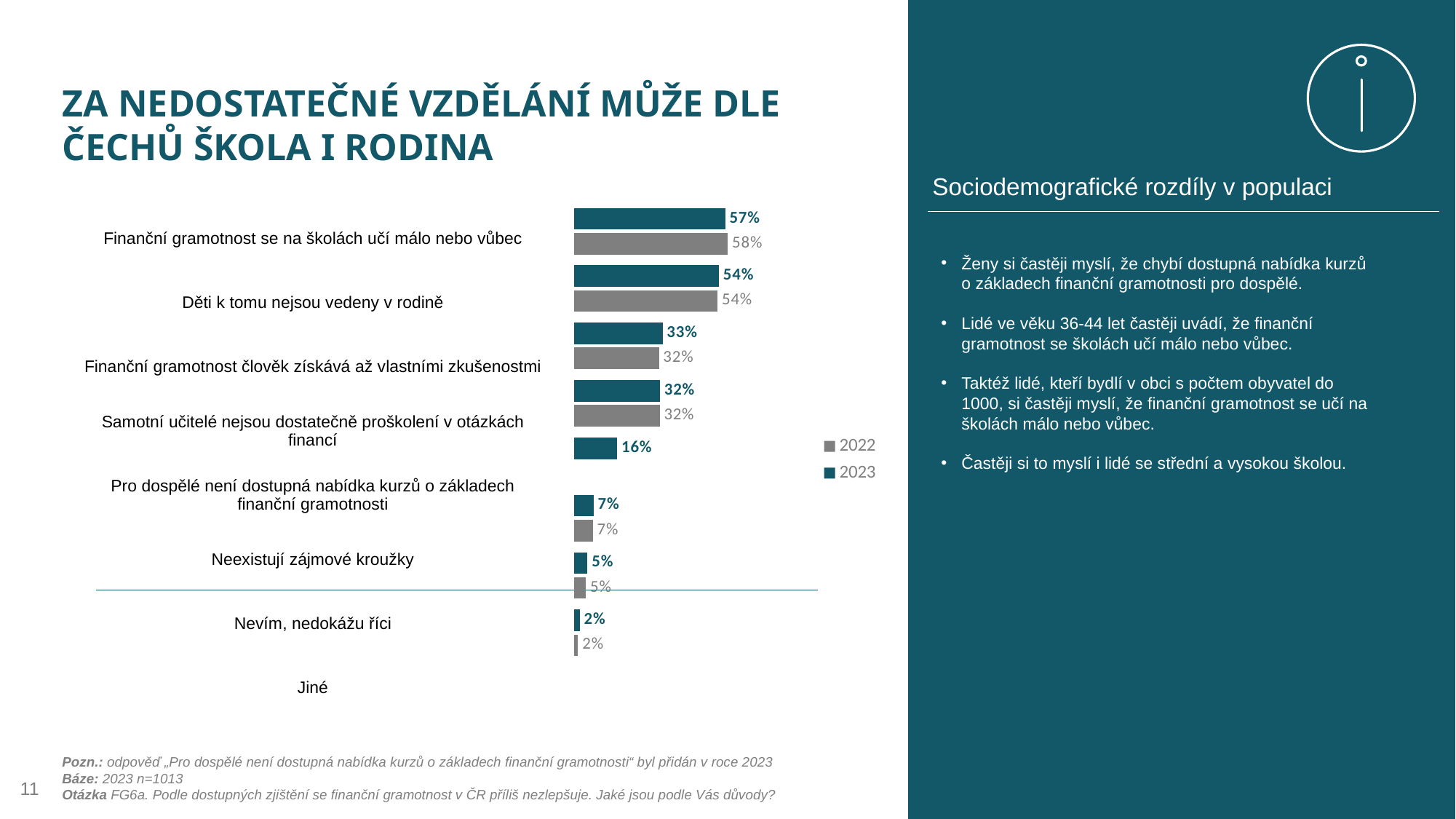
What is the 2022 value for "Finanční gramotnost se na školách učí málo nebo vůbec"? 58% What kind of chart is shown on the slide? bar chart What is the 2023 value for "Děti k tomu nejsou vedeny v rodině"? 54% What is the 2023 value for "Finanční gramotnost se na školách učí málo nebo vůbec"? 57% How many series does the legend list? 2 What is the 2023 value for "Pro dospělé není dostupná nabídka kurzů o základech finanční gramotnosti"? 16% Which category has the lowest 2023 value? Jiné Which years are listed in the chart legend? 2022 and 2023 Which category has the highest 2023 value? Finanční gramotnost se na školách učí málo nebo vůbec What is the difference between the 2023 values for "Děti k tomu nejsou vedeny v rodině" and "Finanční gramotnost člověk získává až vlastními zkušenostmi"? 21 percentage points What is the 2022 value for "Neexistují zájmové kroužky"? 7% Which is larger: the 2023 value for "Finanční gramotnost člověk získává až vlastními zkušenostmi" or the 2023 value for "Nevím, nedokážu říci"? Finanční gramotnost člověk získává až vlastními zkušenostmi